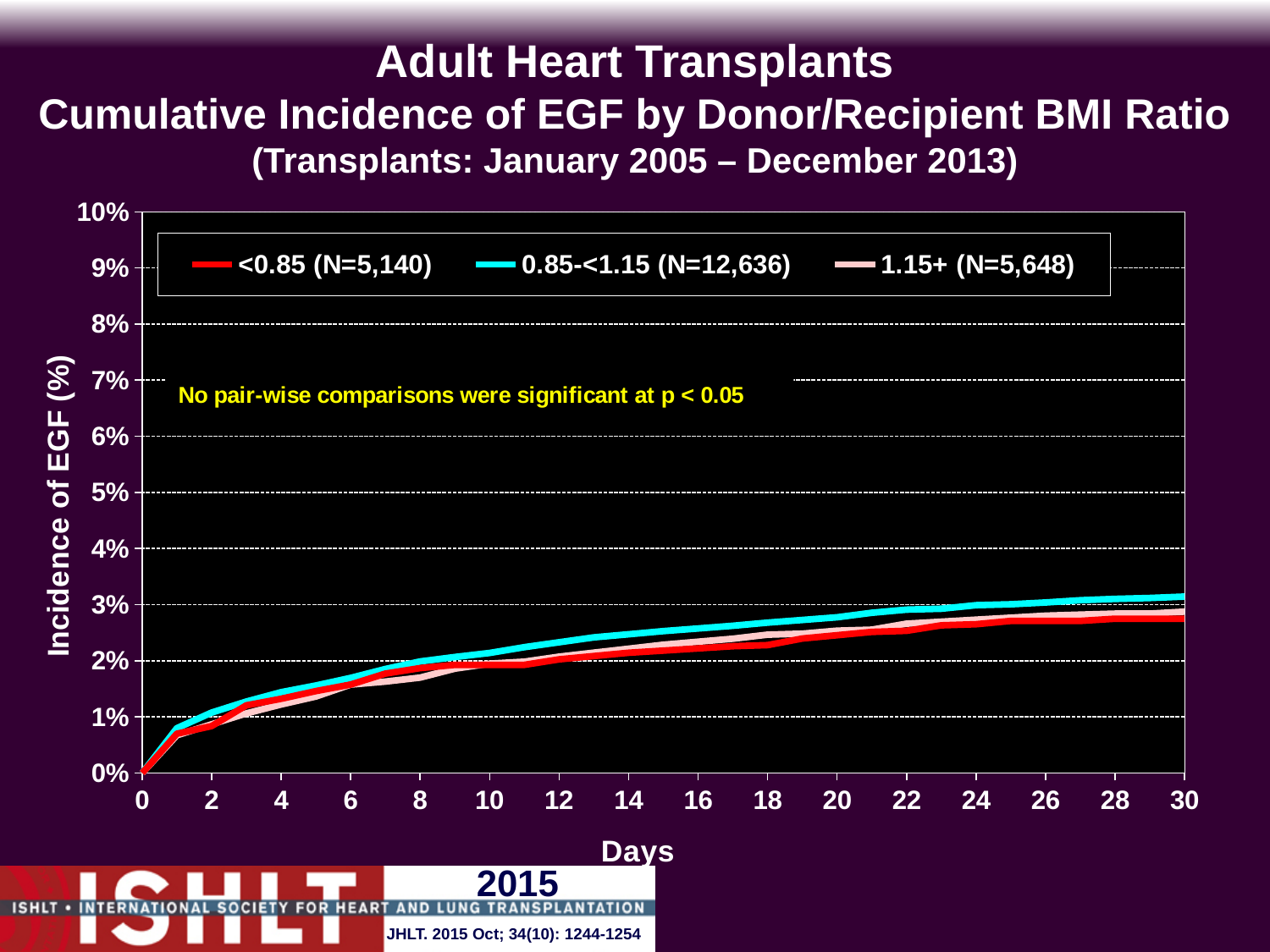
What is the title of the chart? Adult Heart Transplants Cumulative Incidence of EGF by Donor/Recipient BMI Ratio (Transplants: January 2005 – December 2013) What is the N for the 0.85-<1.15 donor/recipient BMI ratio group shown in the legend? 12,636 Is the value for the 0.85-<1.15 group at day 2 greater or less than 2%? less Is the value for the <0.85 group at day 30 greater or less than 2%? greater What is the maximum value shown on the y axis? 10% What is the incidence of EGF for all groups at day 0? 0% Do the cumulative incidence values rise or fall as the number of days increases? rise How many series does the legend list? 3 Is the value for the 0.85-<1.15 group at day 30 greater or less than 4%? less At day 30, which is higher: the 0.85-<1.15 group or the <0.85 group? 0.85-<1.15 What kind of chart is shown on the slide? line chart